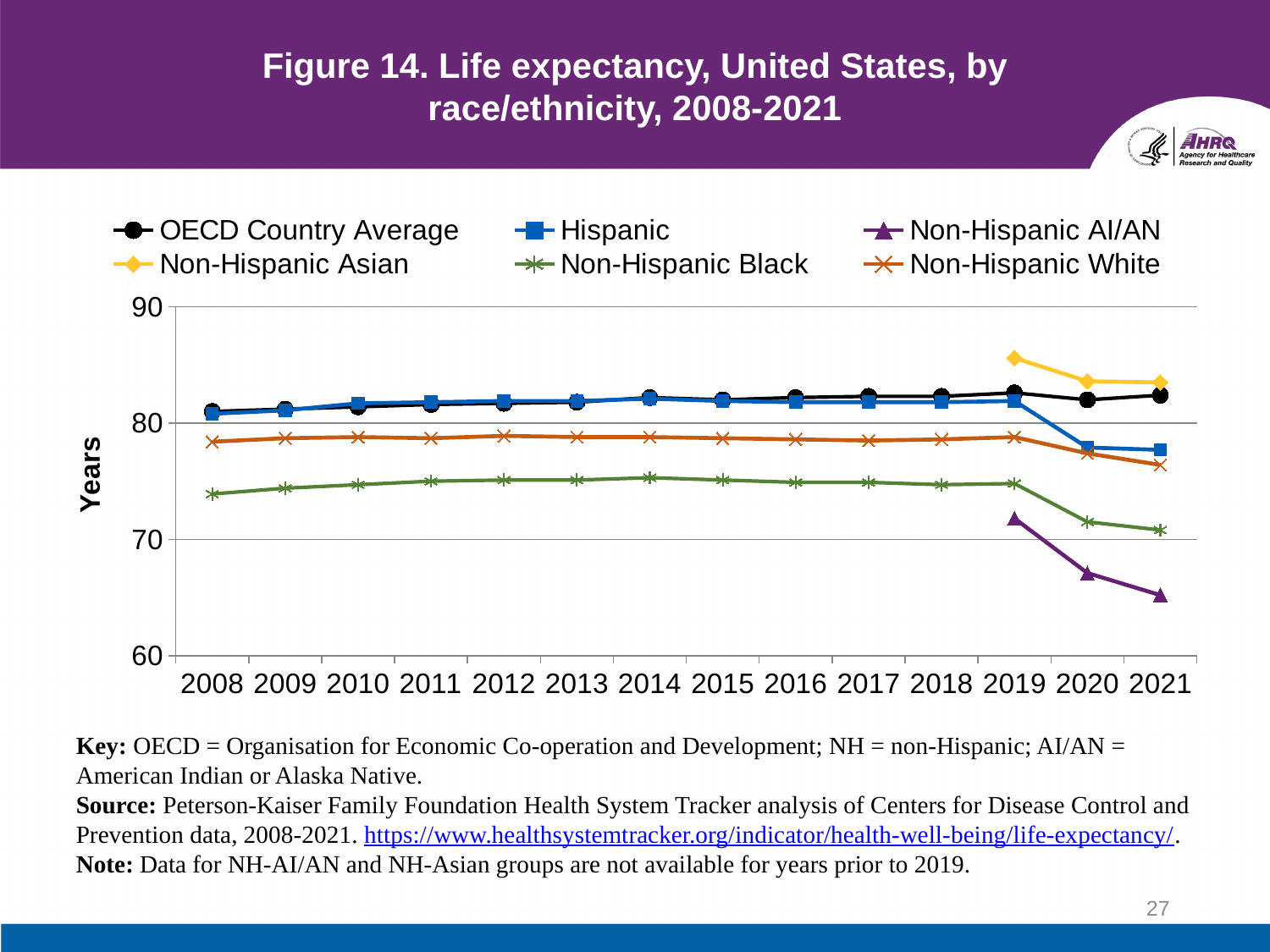
Is the value for Non-Hispanic Asian in 2019 greater or less than 80? greater What is the label on the y axis? Years How many years are shown along the x axis? 14 Which series has the lowest life expectancy in 2021? Non-Hispanic AI/AN Is the value for Non-Hispanic AI/AN in 2021 greater or less than 70? less In 2015, which is higher: Hispanic or Non-Hispanic White? Hispanic Does the Non-Hispanic AI/AN line rise or fall from 2019 to 2021? Fall How many series does the legend list? 6 What kind of chart is shown on the slide? Line chart Is the value for Non-Hispanic White in 2021 greater or less than 80? less Which series has the highest life expectancy in 2021? Non-Hispanic Asian